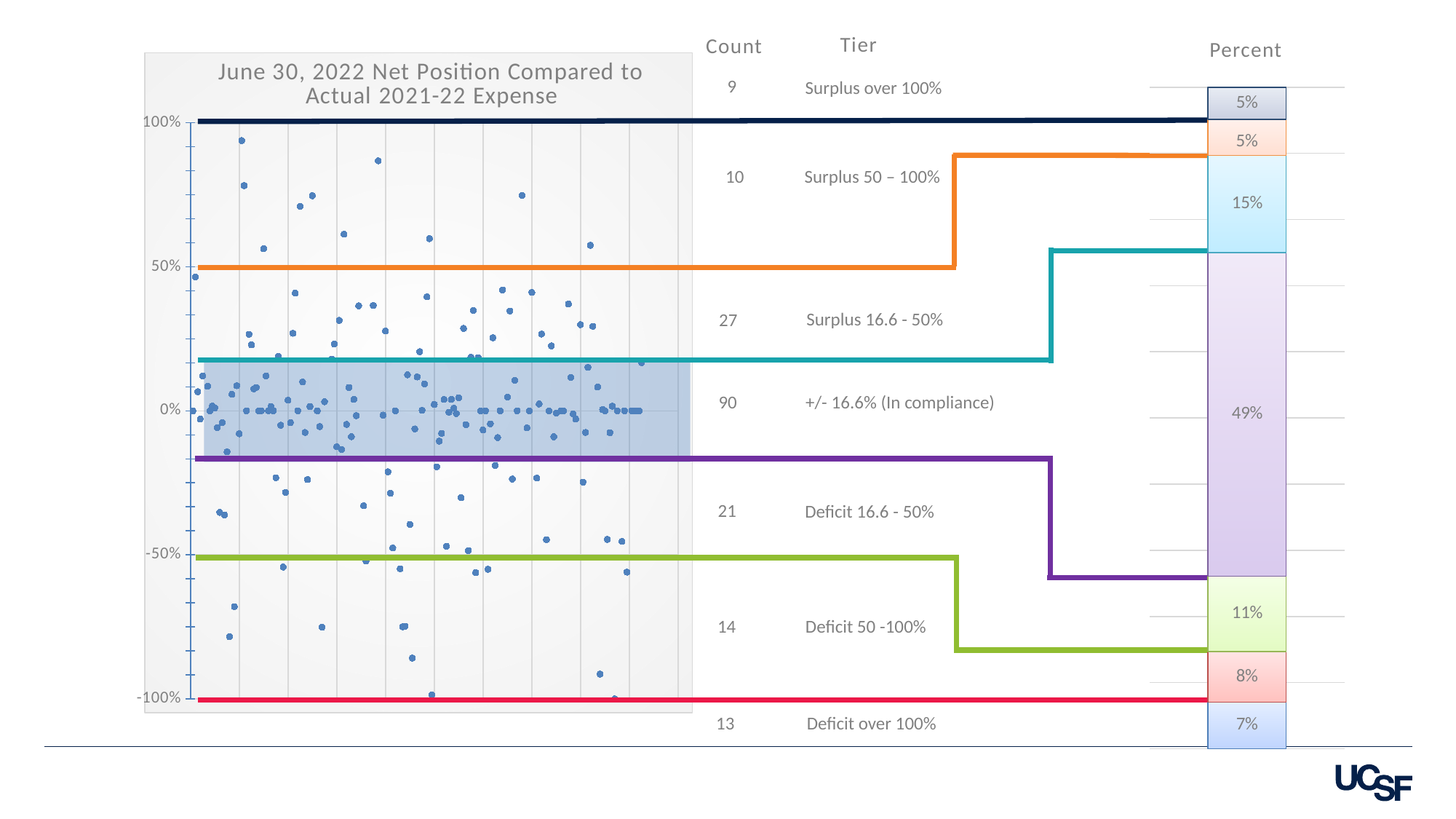
What is the title of the scatter chart on the left of the slide? June 30, 2022 Net Position Compared to Actual 2021-22 Expense In the Percent bar on the right, what percent corresponds to the 'Surplus 16.6 - 50%' tier? 15% In the Percent bar on the right, what share is shown for the '+/- 16.6% (In compliance)' tier? 49% Which tier has the lowest count? Surplus over 100% What is the difference between the count for 'Surplus 16.6 - 50%' and the count for 'Deficit 16.6 - 50%'? 6 What are the lowest and highest values labelled on the vertical axis of the scatter chart? -100% and 100% What kind of chart is the chart on the left of the slide? scatter chart In the Count column, what is the count for the '+/- 16.6% (In compliance)' tier? 90 Which tier has the highest count? +/- 16.6% (In compliance) How many tiers are listed in the Tier column? 7 Which tier has the larger count, 'Deficit 50 -100%' or 'Deficit over 100%'? Deficit 50 -100% In the Count column, what is the count for the 'Deficit over 100%' tier? 13